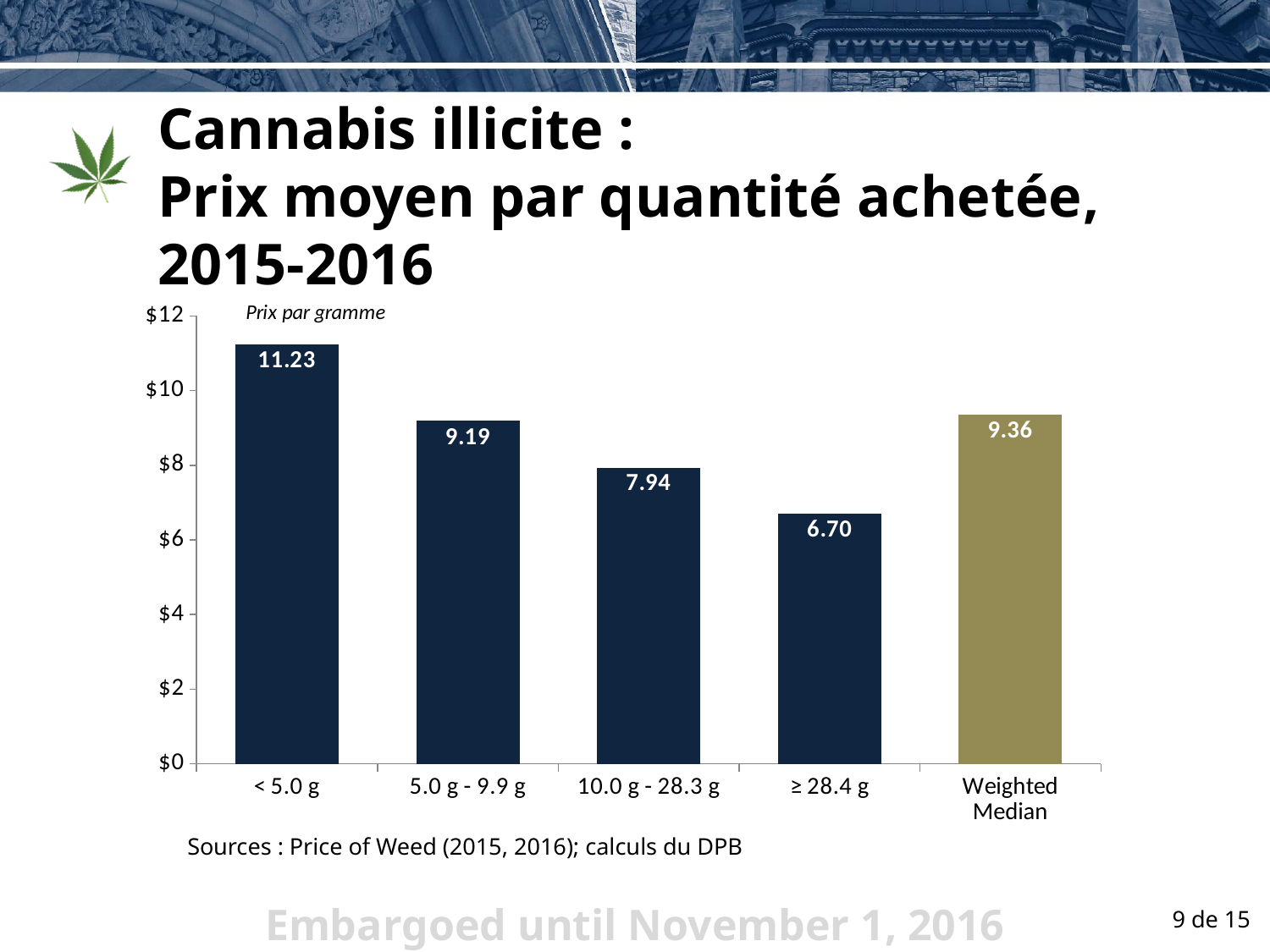
Which category has the highest price per gram? < 5.0 g Which category has the lowest price per gram? ≥ 28.4 g What is the label shown at the top of the chart's y axis area? Prix par gramme How many bars are shown in the chart? 5 What is the price per gram for purchases of < 5.0 g? 11.23 What is the difference between the price per gram for < 5.0 g and for ≥ 28.4 g? 4.53 Which is larger, the price per gram for 10.0 g - 28.3 g or the Weighted Median? Weighted Median What kind of chart is shown on the slide? Bar chart Is the value for 10.0 g - 28.3 g greater or less than $8? less Do the prices rise or fall as the purchased quantity increases across the four quantity categories? Fall What is the value shown for the Weighted Median bar? 9.36 What is the price per gram for the 5.0 g - 9.9 g category? 9.19